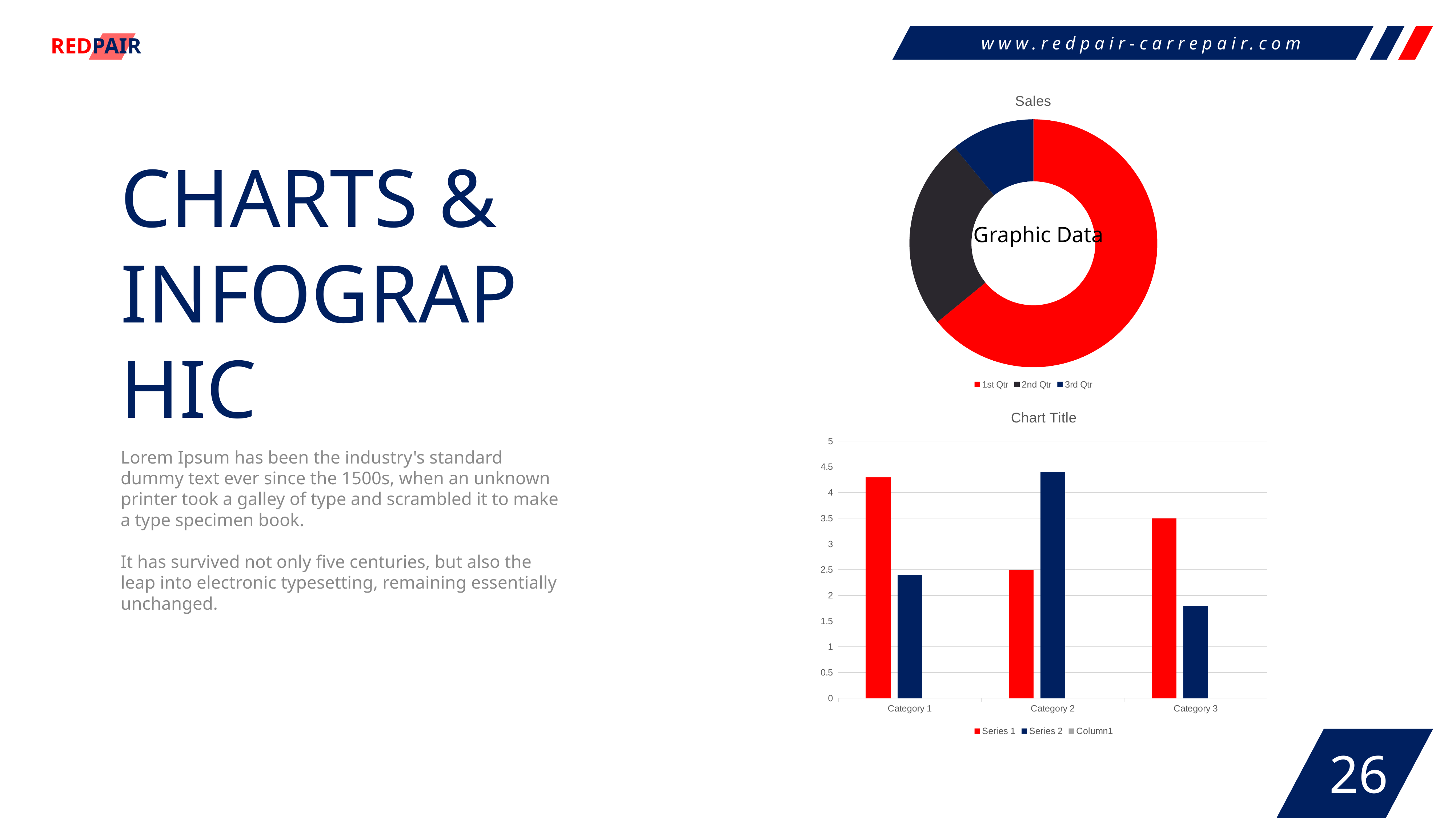
In the "Chart Title" chart, is the Series 2 value for Category 3 greater or less than 2? less What text is shown in the centre of the "Sales" doughnut chart? Graphic Data In the "Sales" chart, which quarter has the smallest slice? 3rd Qtr How many slices does the "Sales" chart have? 3 What kind of chart is the chart titled "Chart Title"? bar chart In the "Chart Title" chart, which is larger for Category 1, Series 1 or Series 2? Series 1 What kind of chart is the "Sales" chart? doughnut chart How many categories are shown on the x axis of the "Chart Title" chart? 3 In the "Chart Title" chart, which category has the highest Series 1 value? Category 1 In the "Sales" chart, which quarter has the largest slice? 1st Qtr In the "Chart Title" chart, which category has the highest Series 2 value? Category 2 How many series does the legend of the "Chart Title" chart list? 3